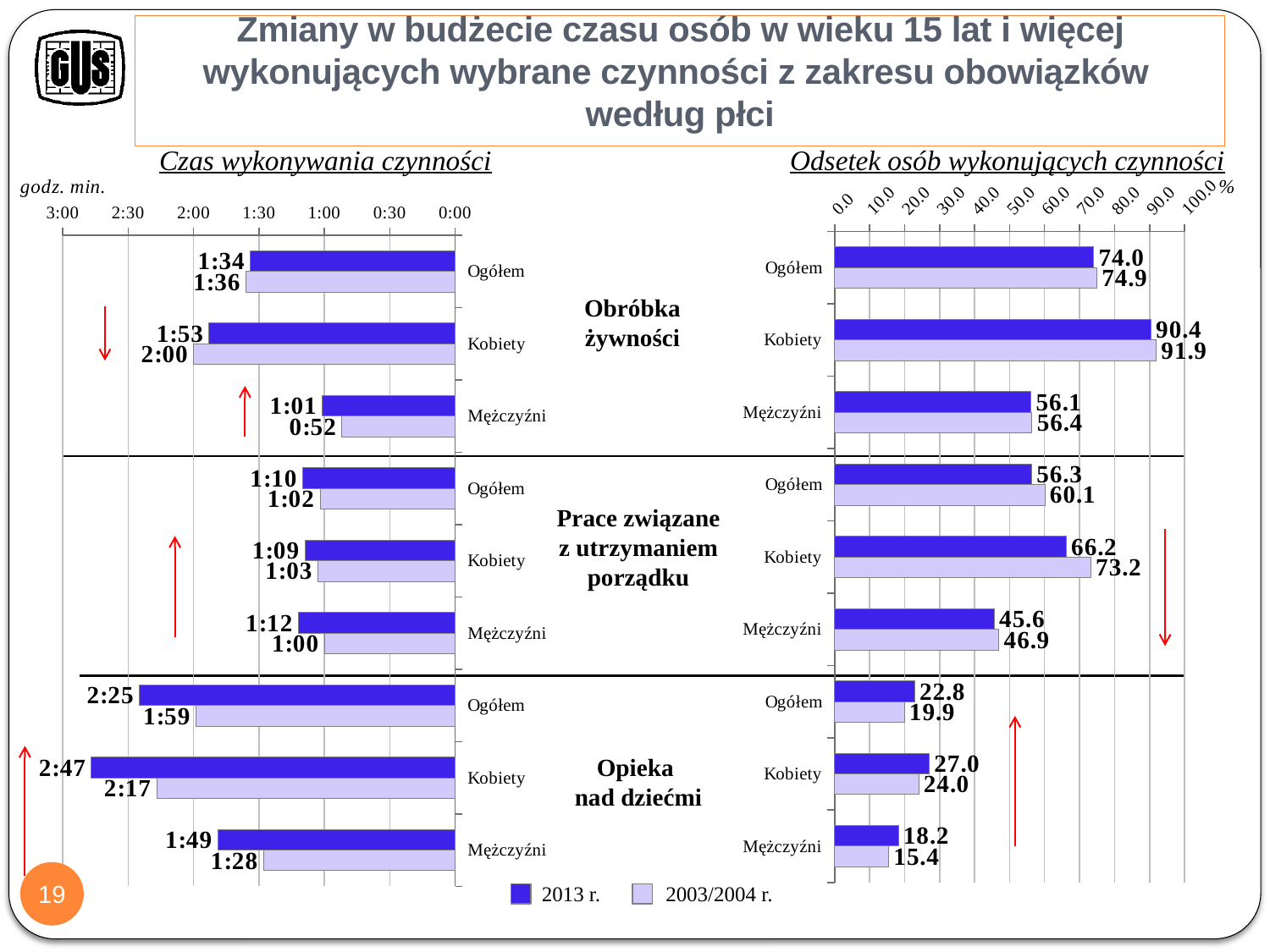
How many series does the legend list for the charts on the slide? 2 In the chart 'Odsetek osób wykonujących czynności', what is the difference between the 2003/2004 r. and 2013 r. values for Kobiety in the 'Prace związane z utrzymaniem porządku' group? 7.0 In the chart 'Odsetek osób wykonujących czynności', which category has the lowest 2003/2004 r. value? Mężczyźni (Opieka nad dziećmi) In the chart 'Odsetek osób wykonujących czynności', what is the 2013 r. value for Mężczyźni in the 'Prace związane z utrzymaniem porządku' group? 45.6 In the chart 'Odsetek osób wykonujących czynności', what is the 2003/2004 r. value for Kobiety in the 'Obróbka żywności' group? 91.9 In the chart 'Czas wykonywania czynności', what is the 2013 r. value for Kobiety in the 'Opieka nad dziećmi' group? 2:47 In the chart 'Odsetek osób wykonujących czynności', is the 2013 r. value for Ogółem in the 'Obróbka żywności' group greater or less than 70.0? greater In the chart 'Odsetek osób wykonujących czynności', which category has the highest 2013 r. value? Kobiety (Obróbka żywności) In the chart 'Czas wykonywania czynności', what is the 2003/2004 r. value for Mężczyźni in the 'Obróbka żywności' group? 0:52 In the chart 'Odsetek osób wykonujących czynności', what is the difference between the 2013 r. and 2003/2004 r. values for Ogółem in the 'Opieka nad dziećmi' group? 2.9 In the chart 'Czas wykonywania czynności', which is larger for Mężczyźni in the 'Opieka nad dziećmi' group: the 2013 r. value or the 2003/2004 r. value? 2013 r. What kind of chart is 'Czas wykonywania czynności'? bar chart